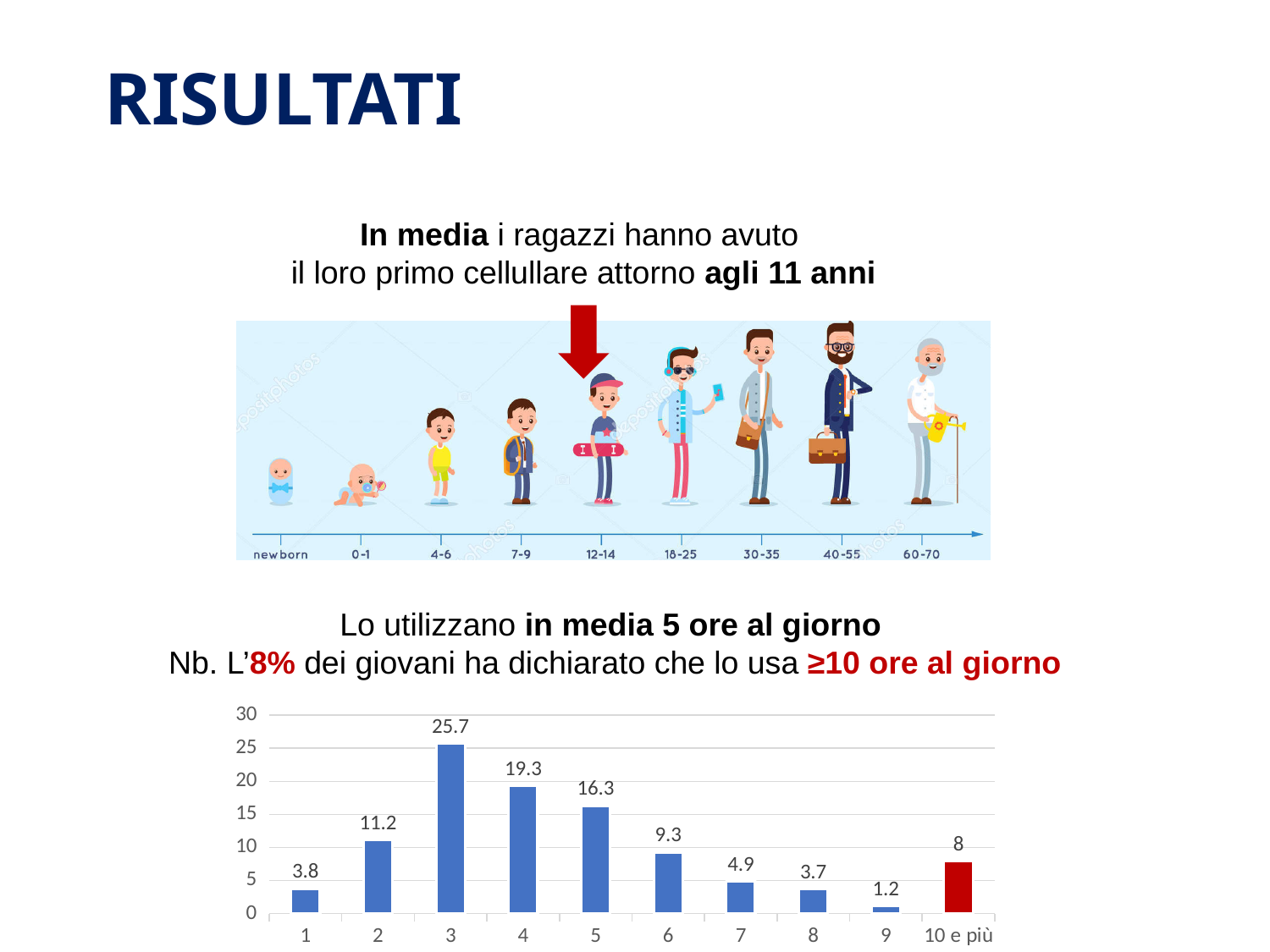
Which category has the lowest value in the bar chart? 9 What kind of chart is shown at the bottom of the slide? bar chart Which is larger in the bar chart: the value for category 5 or the value for category 6? 5 What is the value for the category "10 e più" in the bar chart? 8 What is the value for category 6 in the bar chart? 9.3 What is the difference between the values for category 2 and category 1 in the bar chart? 7.4 Is the value for category 4 in the bar chart greater or less than 15? greater What is the value for category 3 in the bar chart? 25.7 How many categories are shown on the x axis of the bar chart? 10 What is the difference between the values for category 3 and category 4 in the bar chart? 6.4 Which category has the highest value in the bar chart? 3 Which bar in the bar chart is coloured red instead of blue? 10 e più